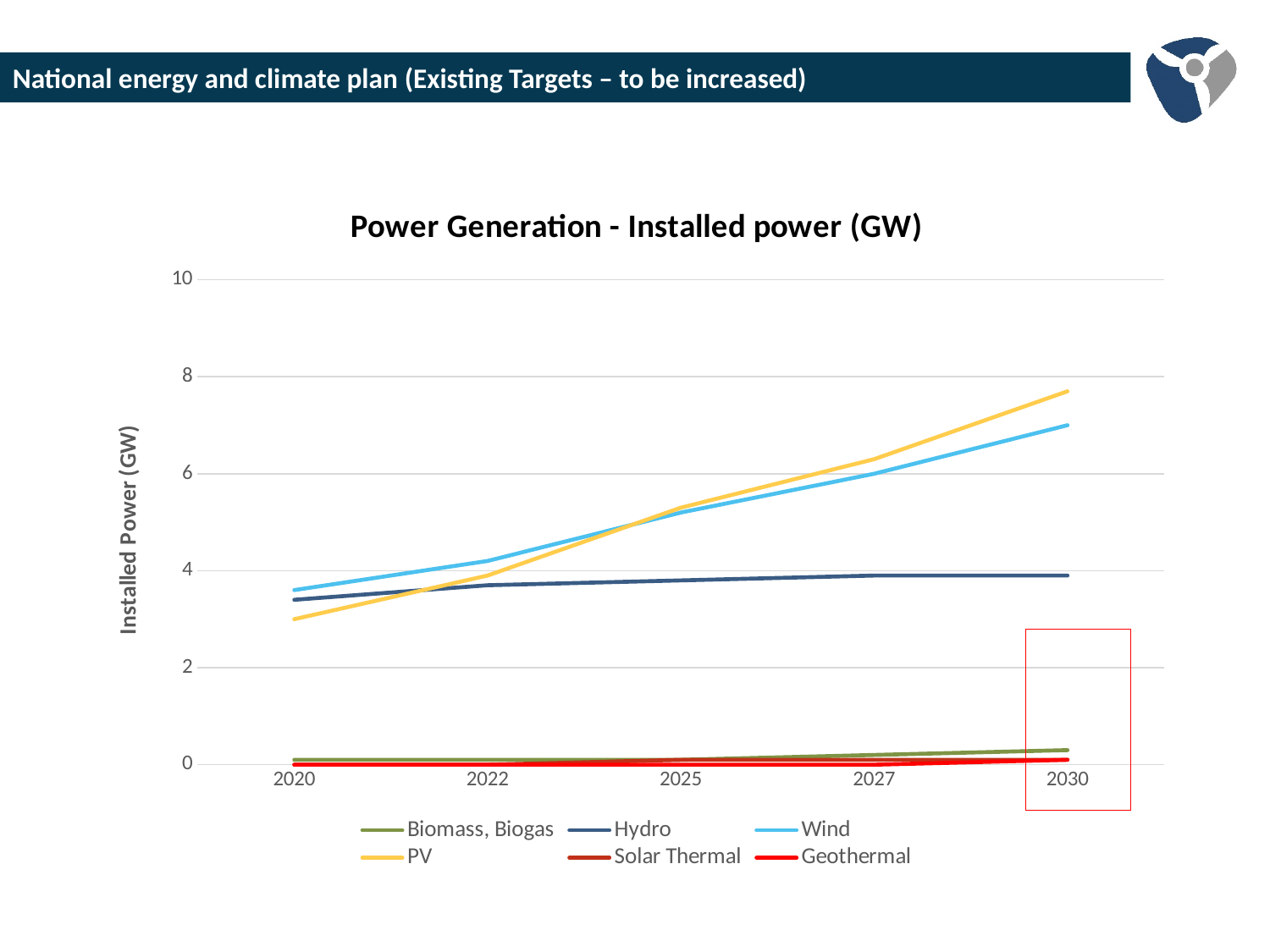
Is the value for Hydro in 2030 greater or less than 4? less What kind of chart is shown on the slide? line chart How many years are marked on the x axis? 5 What is the label of the vertical axis? Installed Power (GW) Is the value for PV in 2030 greater or less than 6? greater In 2020, which is larger, PV or Wind? Wind Does the Wind series rise or fall from 2020 to 2030? rise Does the PV series rise or fall from 2020 to 2030? rise In 2030, which is larger, PV or Wind? PV How many series does the legend list? 6 Which series has the highest installed power in 2030? PV What is the title of the chart? Power Generation - Installed power (GW)